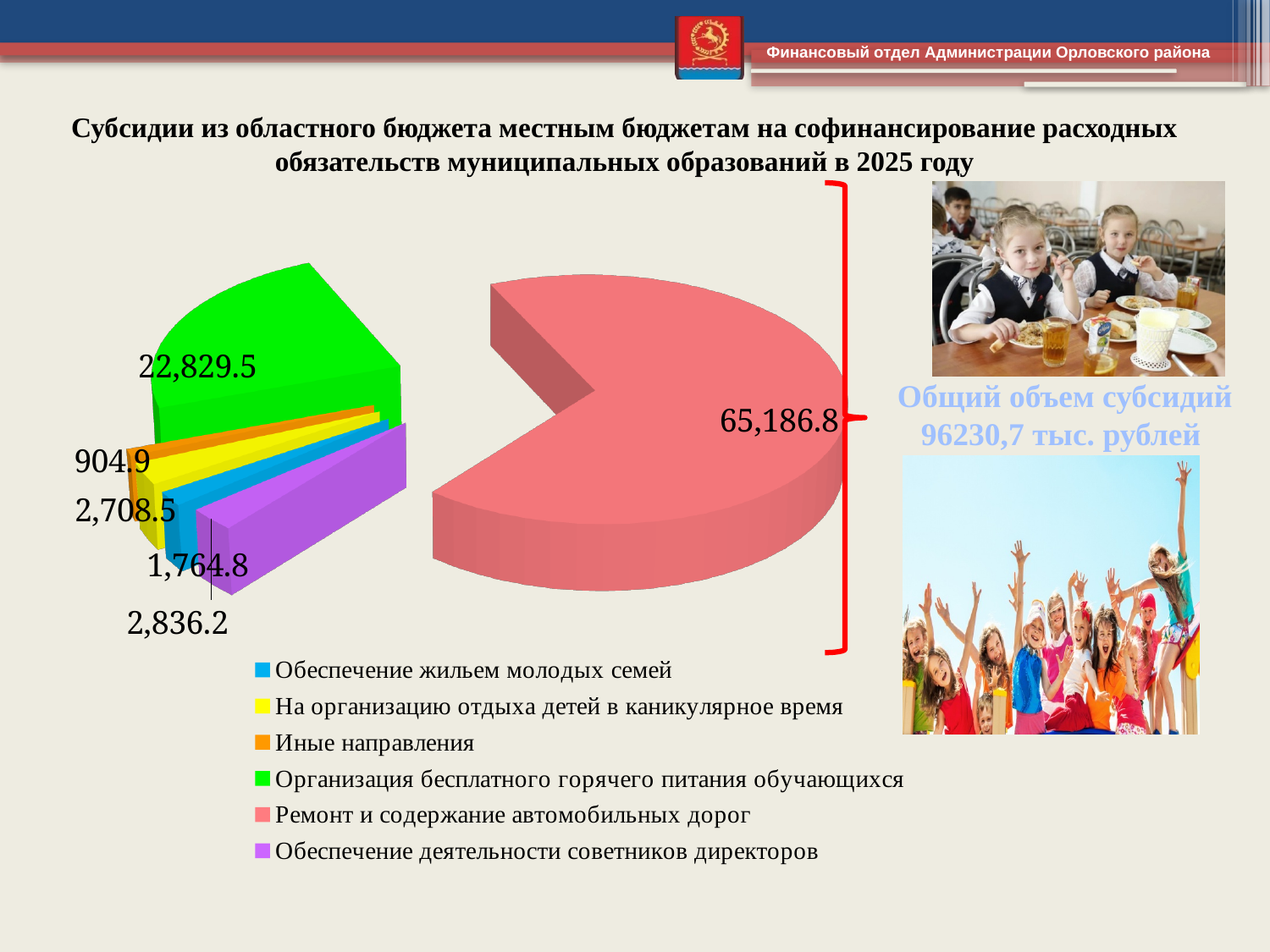
What is the value shown for 'Организация бесплатного горячего питания обучающихся'? 22,829.5 What total volume of subsidies is stated next to the pie chart? 96230,7 тыс. рублей Which category has the largest slice in the pie chart? Ремонт и содержание автомобильных дорог How many categories does the legend of the pie chart list? 6 How many data labels are shown on the pie chart? 6 What type of chart is shown on the slide? Pie chart Which year does the slide title say the subsidies refer to? 2025 What is the smallest value labelled on the pie chart? 904.9 What is the value shown for 'Ремонт и содержание автомобильных дорог'? 65,186.8 Which is larger: the value for 'Ремонт и содержание автомобильных дорог' or for 'Организация бесплатного горячего питания обучающихся'? Ремонт и содержание автомобильных дорог What is the difference between the values for 'Ремонт и содержание автомобильных дорог' and 'Организация бесплатного горячего питания обучающихся'? 42,357.3